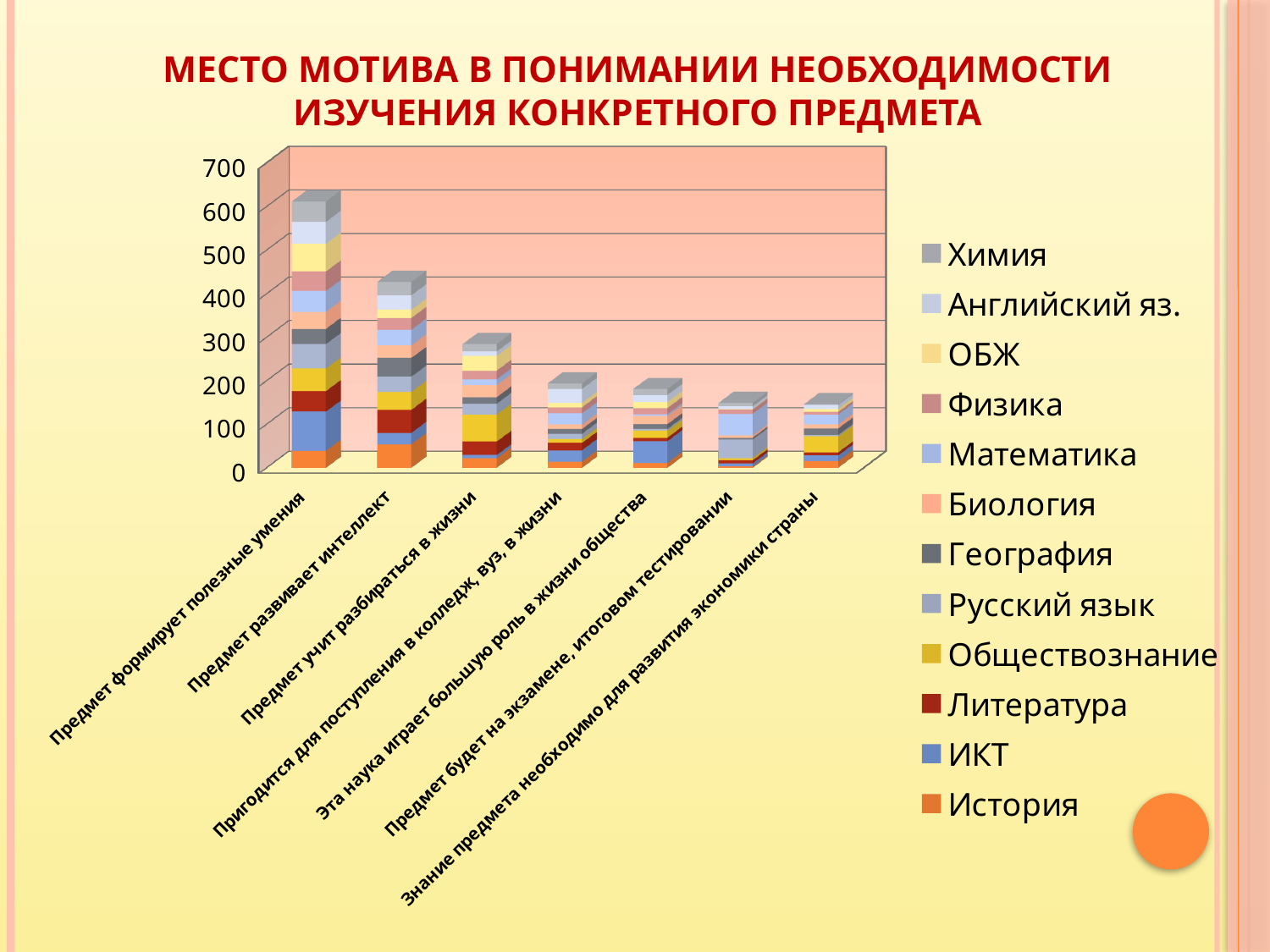
Which is larger: the total for "Предмет развивает интеллект" or for "Предмет учит разбираться в жизни"? Предмет развивает интеллект How many categories (motives) are shown along the x axis of the chart? 7 Which is larger: the total for "Предмет формирует полезные умения" or for "Предмет развивает интеллект"? Предмет формирует полезные умения Which series is listed first in the chart's legend? Химия What kind of chart is shown on the slide? Stacked bar chart How many series does the chart's legend list? 12 Is the total for "Предмет развивает интеллект" greater or less than 300? greater Do the stacked bar totals rise or fall moving from left to right along the x axis? fall Is the total for "Предмет формирует полезные умения" greater or less than 500? greater Which category has the tallest stacked bar? Предмет формирует полезные умения What is the title of the slide containing the chart? Место мотива в понимании необходимости изучения конкретного предмета Is the total for "Пригодится для поступления в колледж, вуз, в жизни" greater or less than 300? less